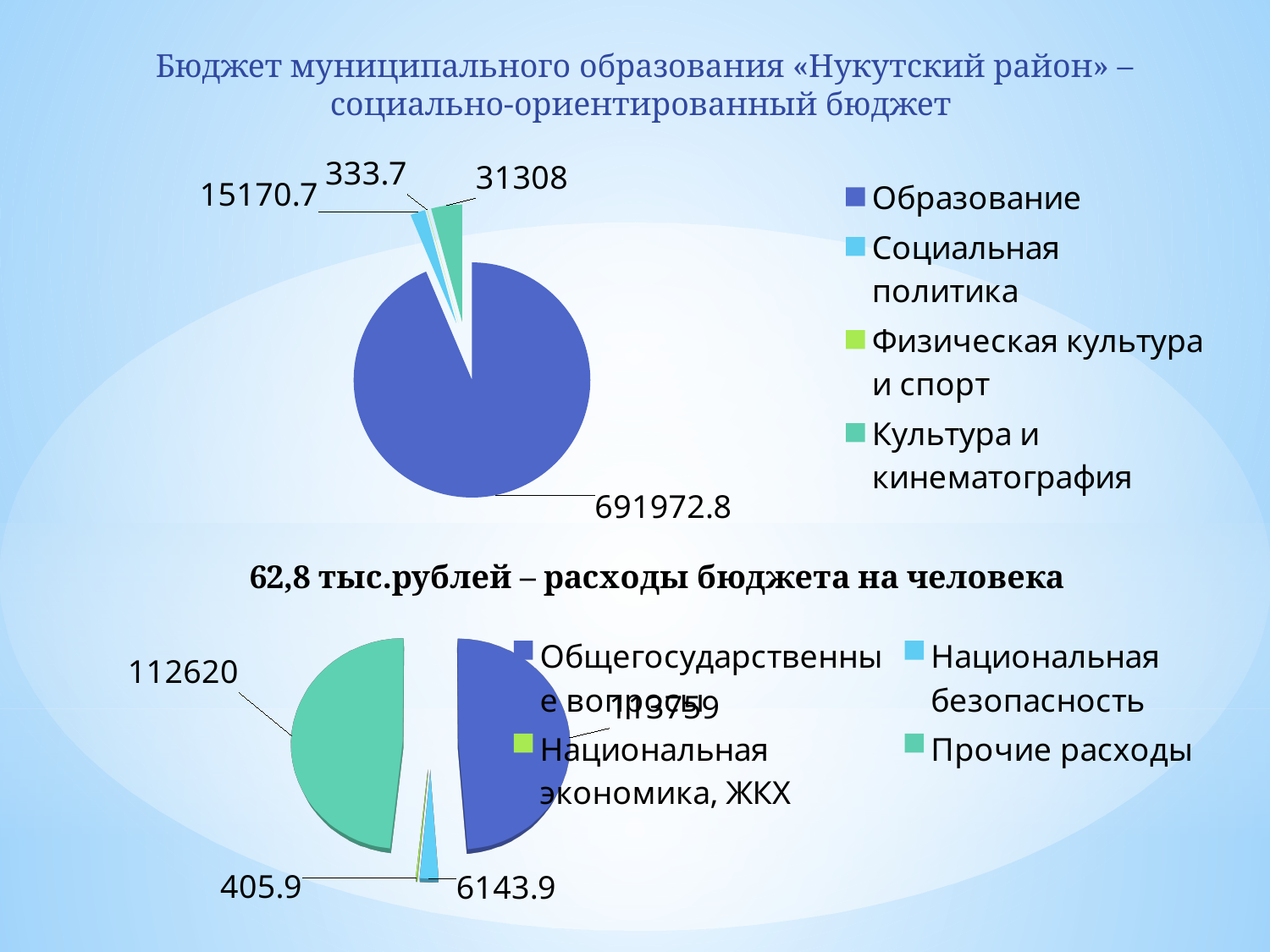
In the bottom pie chart, what is the difference between Национальная безопасность and Национальная экономика, ЖКХ? 5738 In the top pie chart, what is the value for Культура и кинематография? 31308 In the top pie chart, what is the value for Образование? 691972.8 In the bottom pie chart, what is the value for Прочие расходы? 112620 In the bottom pie chart, which category has the smallest value? Национальная экономика, ЖКХ In the top pie chart, which category has the smallest value? Физическая культура и спорт In the bottom pie chart, what is the value for Национальная безопасность? 6143.9 What type of chart is the top chart on the slide? Pie chart How many categories does the legend of the top pie chart list? 4 In the top pie chart, which category has the largest value? Образование In the top pie chart, what is the value for Социальная политика? 15170.7 In the top pie chart, what is the difference between Культура и кинематография and Социальная политика? 16137.3